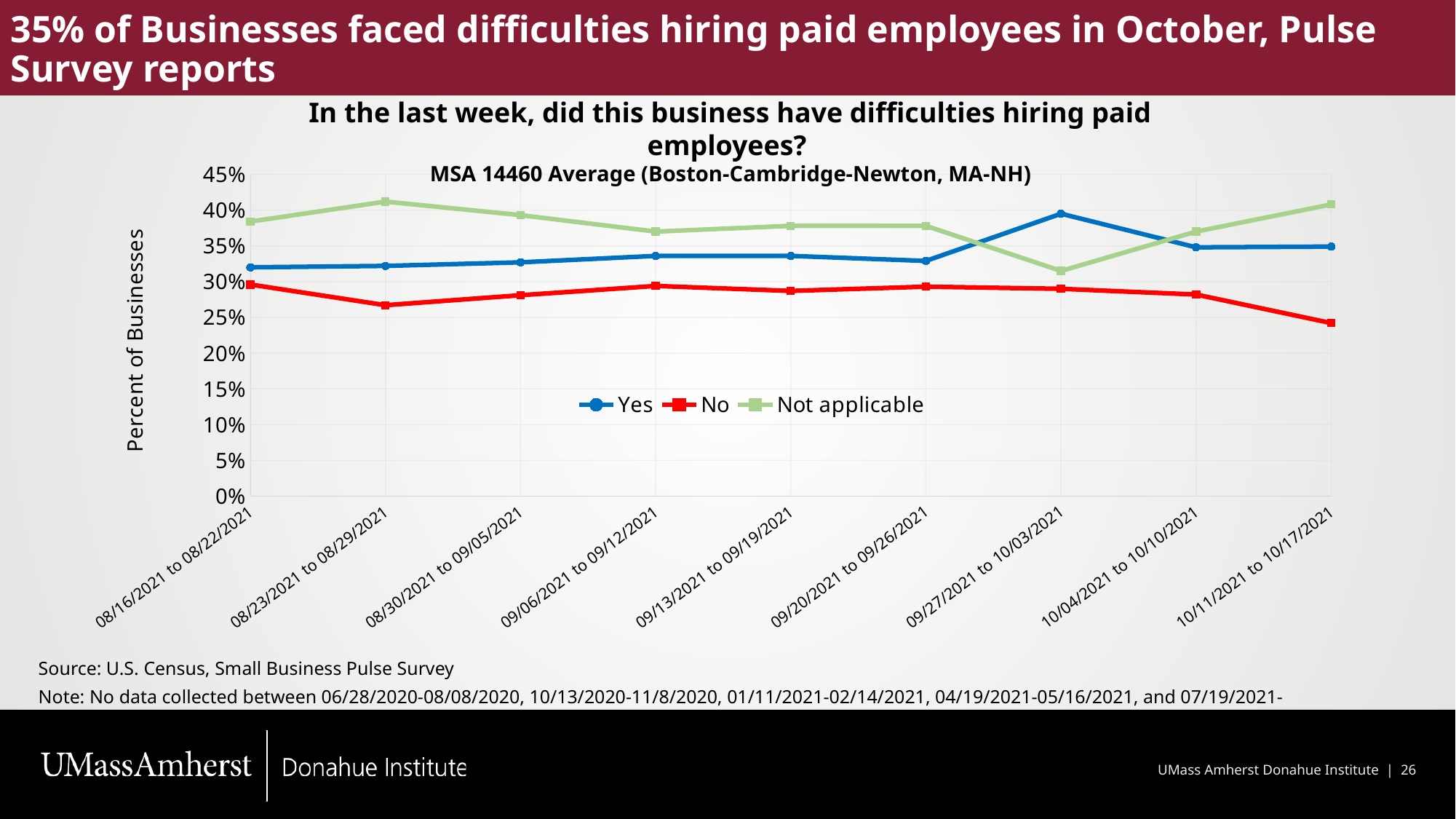
Is the value for Not applicable in the period 09/27/2021 to 10/03/2021 greater or less than 35%? less In which period does the No series reach its lowest value? 10/11/2021 to 10/17/2021 What kind of chart is shown on the slide? line chart Is the value for Yes in the period 09/27/2021 to 10/03/2021 greater or less than 35%? greater In which period does the Yes series reach its highest value? 09/27/2021 to 10/03/2021 How many series does the legend list? 3 How many weekly periods are plotted along the x axis? 9 Does the No series rise or fall between the period 10/04/2021 to 10/10/2021 and the period 10/11/2021 to 10/17/2021? fall In the period 08/16/2021 to 08/22/2021, which is larger: Yes or Not applicable? Not applicable Is the value for No in the period 10/11/2021 to 10/17/2021 greater or less than 25%? less In the period 09/27/2021 to 10/03/2021, which is larger: Yes or Not applicable? Yes